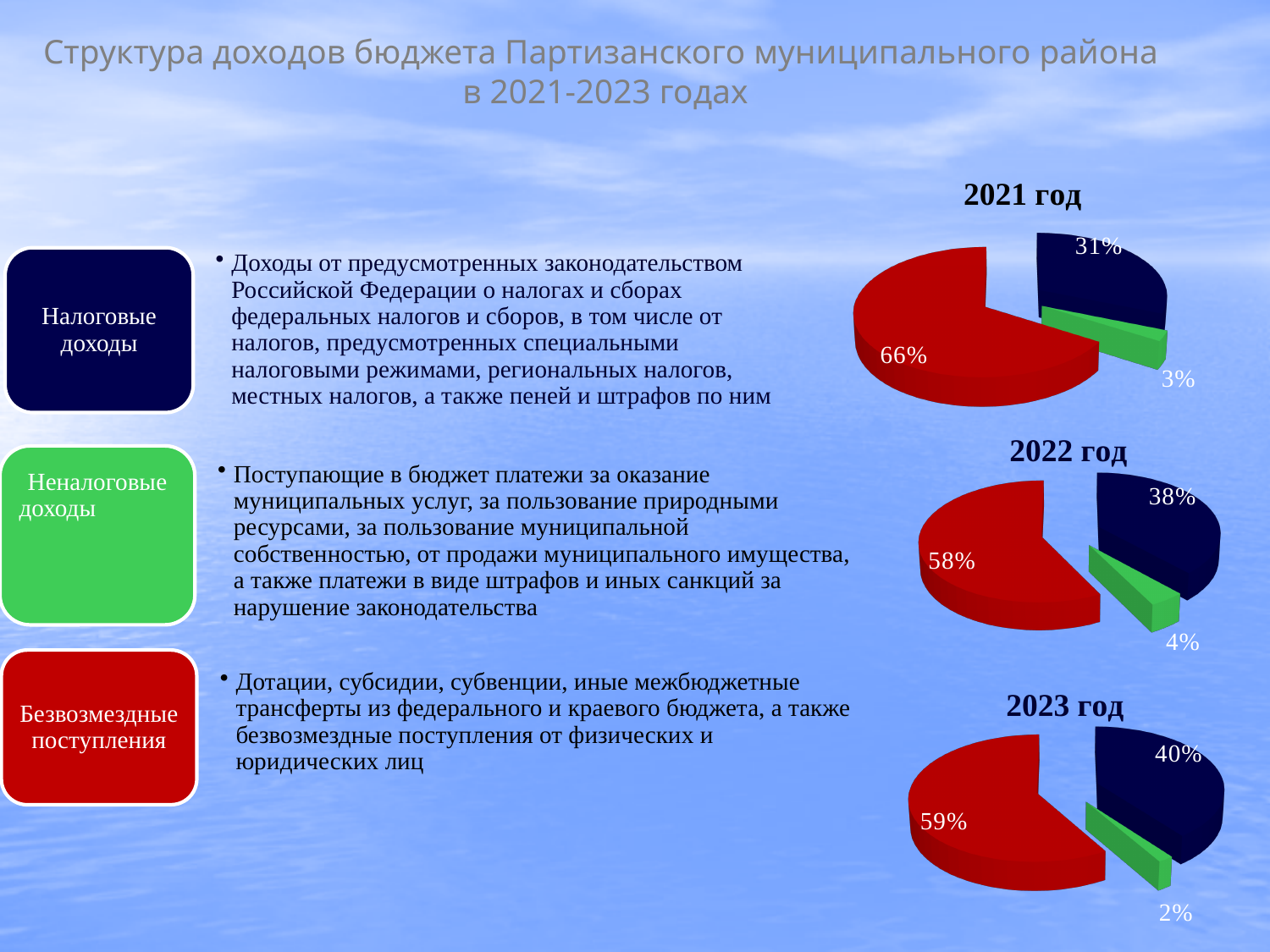
In the 2022 год chart, what share is shown for the green slice (Неналоговые доходы)? 4% In the 2021 год chart, what share is shown for the dark blue slice (Налоговые доходы)? 31% In the 2023 год chart, what share is shown for the dark blue slice (Налоговые доходы)? 40% In the 2022 год chart, which category has the smallest slice? Неналоговые доходы In the 2021 год chart, what share is shown for the red slice (Безвозмездные поступления)? 66% What type of chart is used for 2021 год, 2022 год and 2023 год? Pie chart How many slices does the 2023 год pie chart have? 3 Across the 2021, 2022 and 2023 charts, does the share of Налоговые доходы (dark blue) rise or fall over the years? Rise In the 2022 год chart, which is larger: the dark blue slice (Налоговые доходы) or the red slice (Безвозмездные поступления)? Безвозмездные поступления In the 2023 год chart, which category has the largest slice? Безвозмездные поступления In the 2021 год chart, what is the difference between the red slice (66%) and the dark blue slice (31%)? 35% How many pie charts are shown on the slide? 3